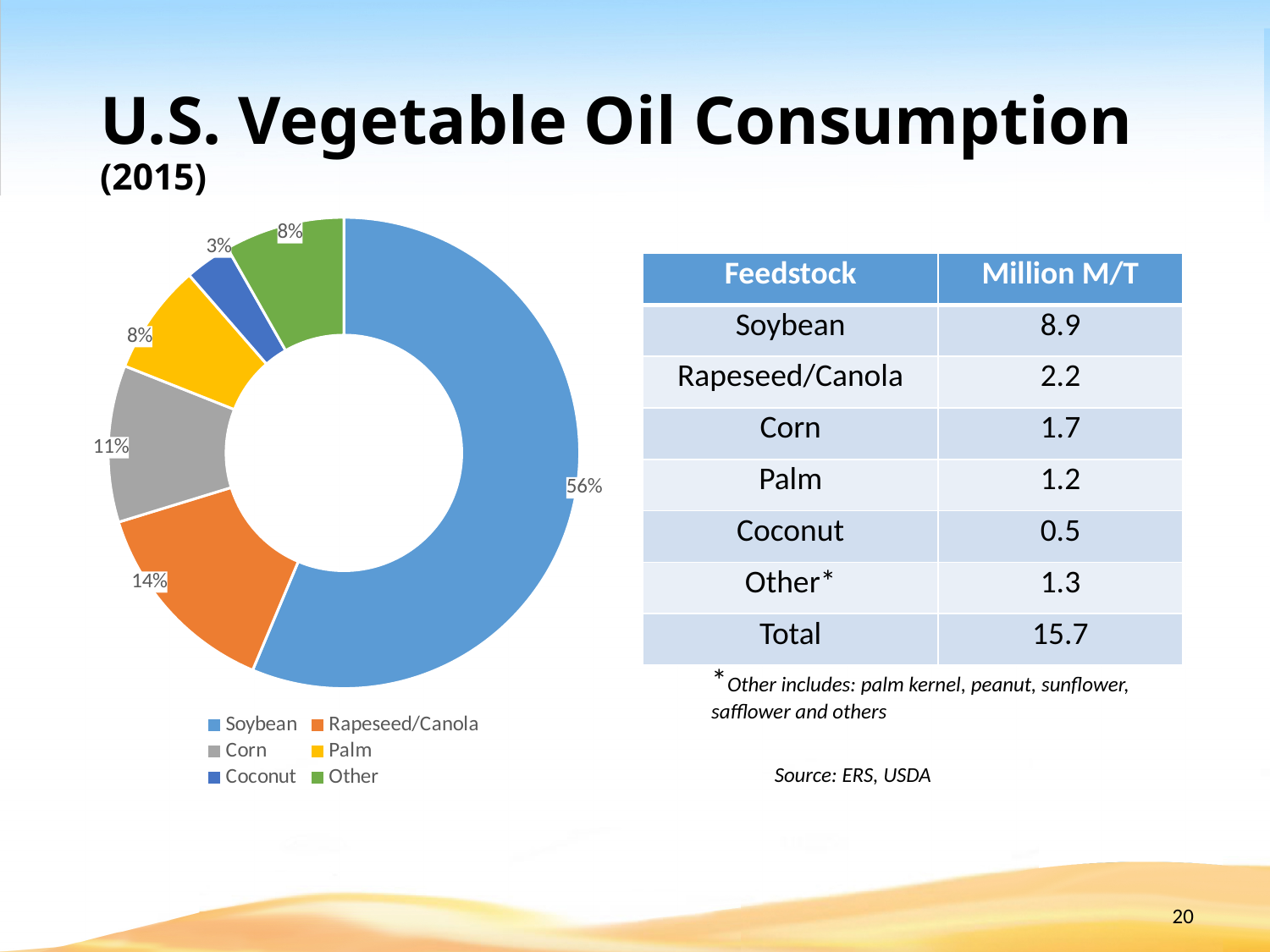
What kind of chart is shown on the slide? Doughnut (pie) chart What percentage is shown for Corn in the chart? 11% Which feedstock has the smallest slice in the chart? Coconut How many percentage points larger is the Soybean slice than the Rapeseed/Canola slice? 42 What colour is the Rapeseed/Canola slice in the chart? Orange What percentage is shown for Rapeseed/Canola in the chart? 14% Which slice is larger, Corn or Palm? Corn What percentage is shown for Coconut in the chart? 3% What is the title of the slide containing the chart? U.S. Vegetable Oil Consumption (2015) How many categories does the legend of the chart list? 6 Which feedstock has the largest slice in the chart? Soybean What share of the doughnut chart does Soybean account for? 56%